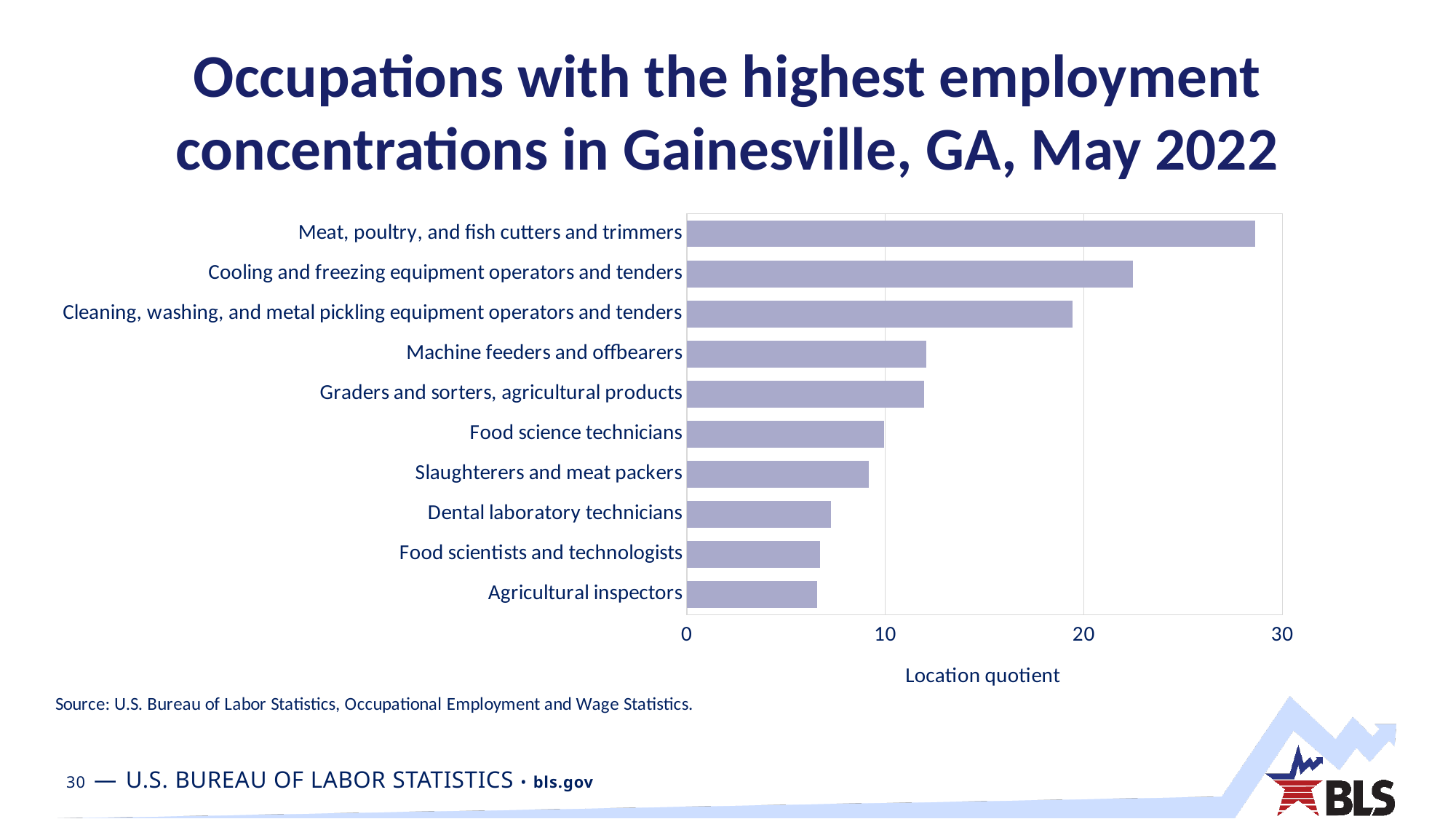
What is the label on the horizontal axis of the chart? Location quotient Which occupation has the lowest location quotient? Agricultural inspectors Which has a larger location quotient, Cooling and freezing equipment operators and tenders or Graders and sorters, agricultural products? Cooling and freezing equipment operators and tenders What kind of chart is shown on the slide? Bar chart Which has a larger location quotient, Slaughterers and meat packers or Dental laboratory technicians? Slaughterers and meat packers Is the location quotient for Cleaning, washing, and metal pickling equipment operators and tenders greater or less than 20? less Is the location quotient for Cooling and freezing equipment operators and tenders greater or less than 20? greater Is the location quotient for Machine feeders and offbearers greater or less than 10? greater How many occupations are plotted in the chart? 10 Which occupation has the highest location quotient? Meat, poultry, and fish cutters and trimmers